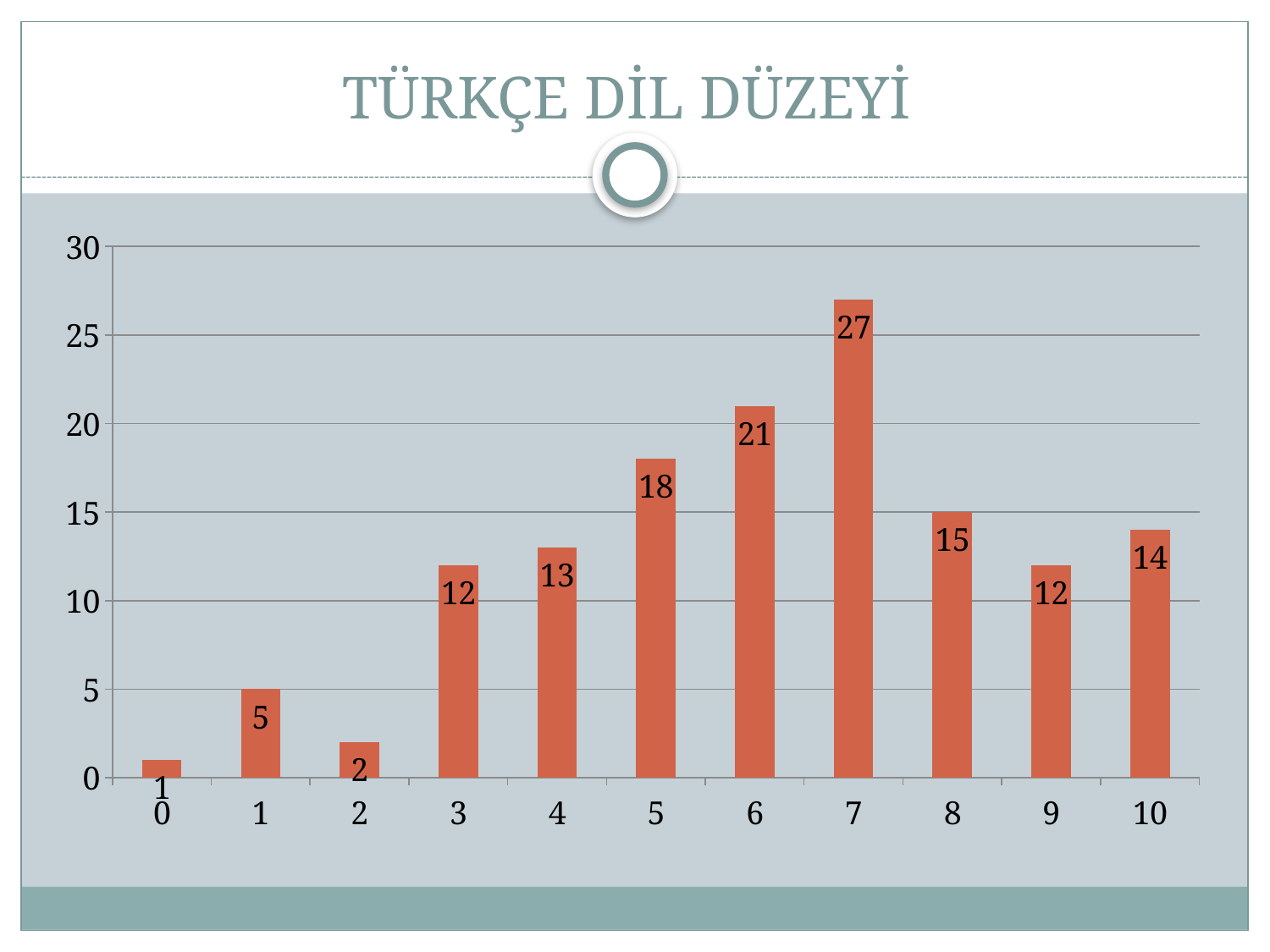
What is the value for category 7? 27 What is the difference between the values for category 7 and category 6? 6 What is the value for category 10? 14 What kind of chart is shown on the slide? bar chart How many categories are shown on the x axis? 11 Which category has the lowest value? 0 Which category has the highest value? 7 Is the value for category 6 greater or less than 20? greater What is the difference between the values for category 8 and category 1? 10 Which is larger, the value for category 5 or the value for category 8? 5 What is the title of the slide? TÜRKÇE DİL DÜZEYİ What is the value for category 3? 12